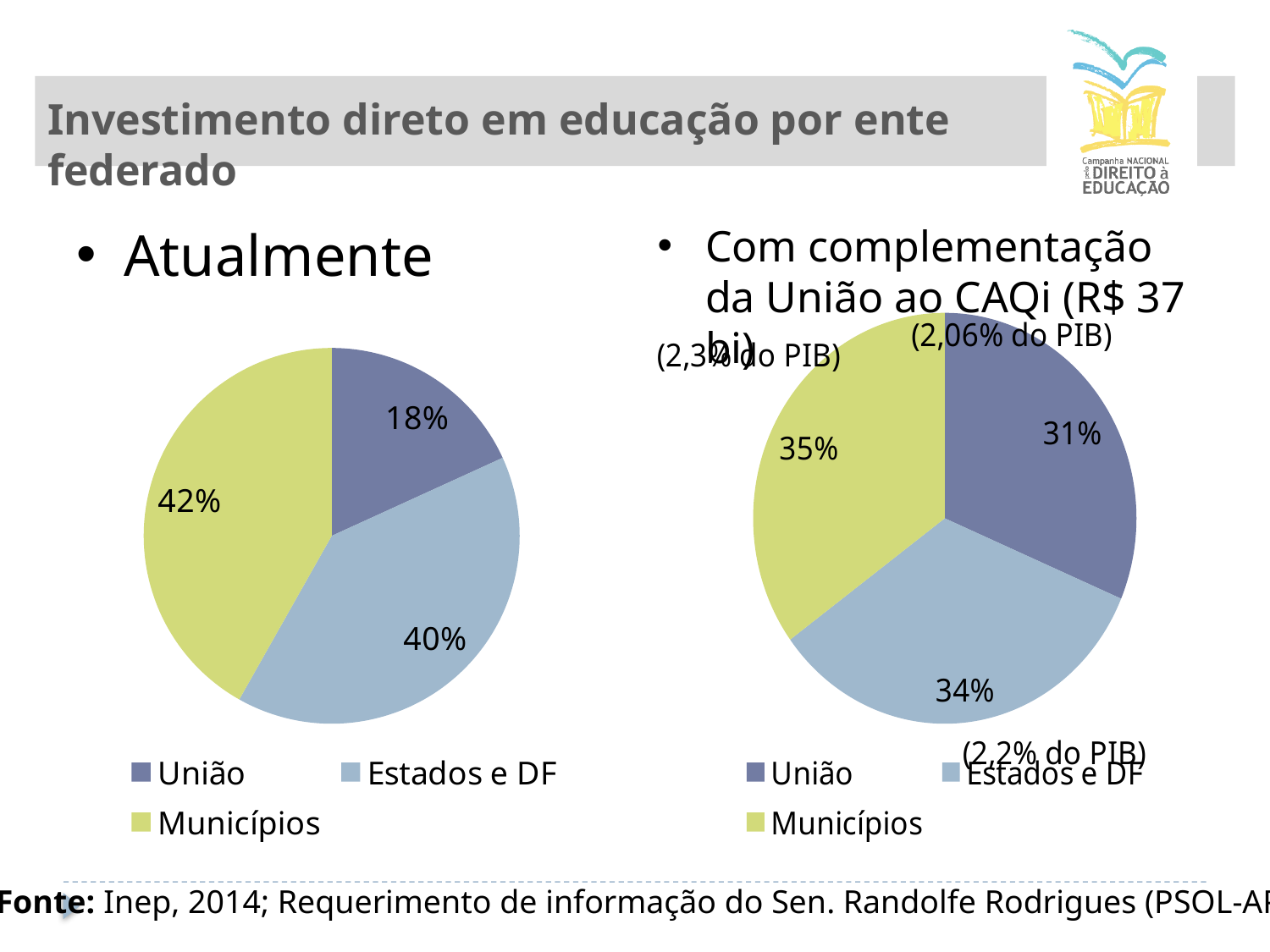
In the right pie chart (Com complementação da União ao CAQi), what share do Estados e DF have? 34% What is the difference between the União share in the right pie chart (31%) and in the left pie chart (18%)? 13 percentage points What type of chart is used on this slide? Pie chart In the right pie chart (Com complementação da União ao CAQi), which category has the smallest share? União In the left pie chart (Atualmente), what share do Estados e DF have? 40% In the left pie chart (Atualmente), which category has the smallest share? União How many slices does each pie chart on the slide have? 3 In the left pie chart (Atualmente), what is the difference between the Municípios share and the União share? 24 percentage points In the left pie chart (Atualmente), what share do Municípios have? 42% In the left pie chart (Atualmente), what share does União have? 18% In the right pie chart (Com complementação da União ao CAQi), what share does União have? 31% In the left pie chart (Atualmente), which category has the largest share? Municípios